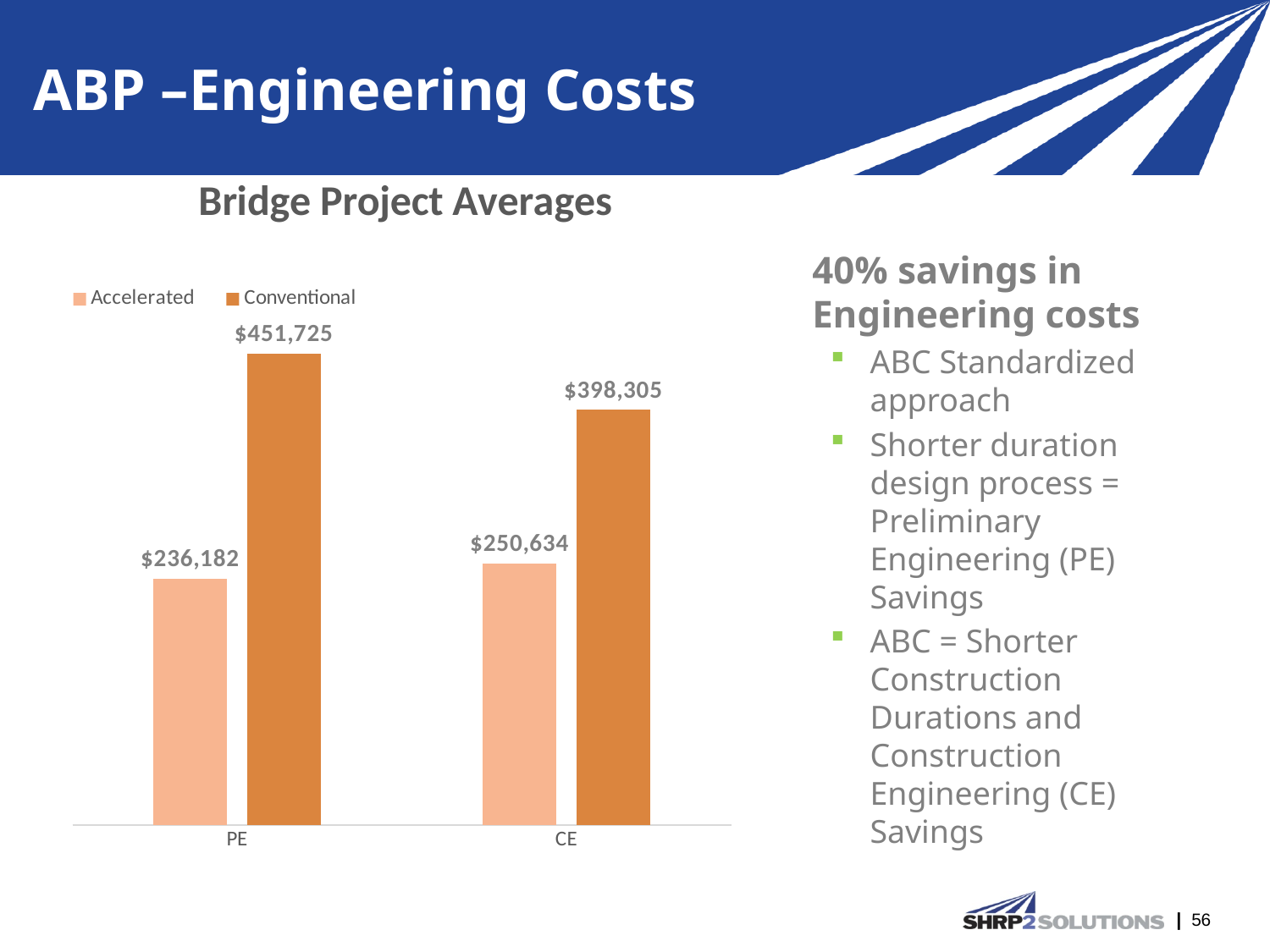
What is the Accelerated value for PE? $236,182 What is the difference between the Conventional and Accelerated values for PE? $215,543 Which category has the lowest Accelerated value? PE What is the Conventional value for PE? $451,725 Which category has the highest Conventional value? PE How many series does the legend list? 2 What is the Accelerated value for CE? $250,634 What is the difference between the Conventional and Accelerated values for CE? $147,671 What kind of chart is shown on the slide? Bar chart Which is larger for CE, the Accelerated value or the Conventional value? Conventional What is the Conventional value for CE? $398,305 How many categories are shown on the x axis? 2